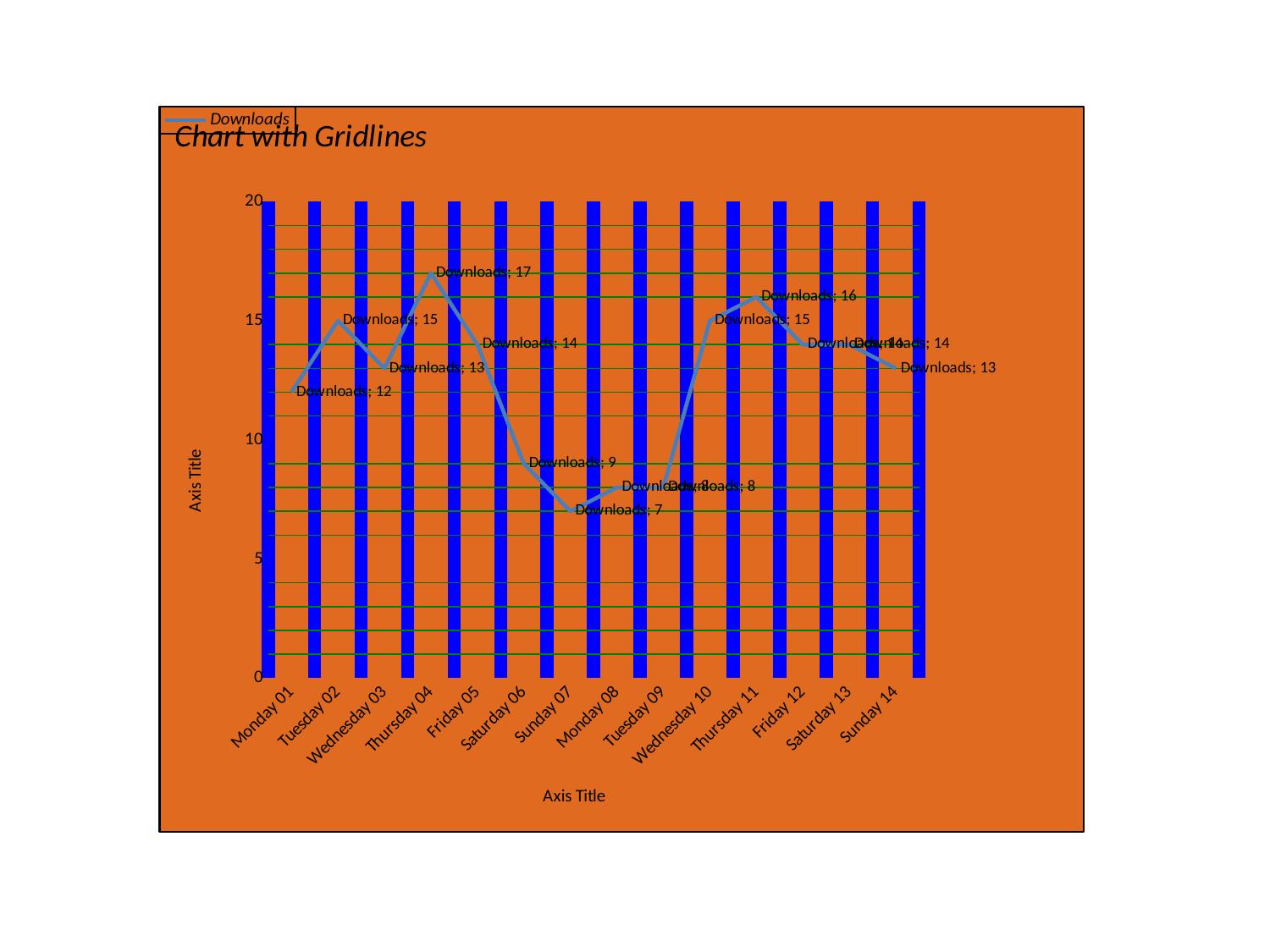
How many days are plotted on the x axis? 14 What is the Downloads value for Wednesday 10? 15 What is the Downloads value for Monday 01? 12 Do the Downloads values rise or fall from Thursday 04 to Sunday 07? fall Which has a higher Downloads value, Tuesday 02 or Wednesday 03? Tuesday 02 Which day has the lowest Downloads value? Sunday 07 Which day has the highest Downloads value? Thursday 04 What is the difference between the Downloads values for Thursday 04 and Sunday 07? 10 What is the title of the chart? Chart with Gridlines What is the Downloads value for Sunday 07? 7 What is the Downloads value for Thursday 04? 17 What type of chart is shown on the slide? line chart